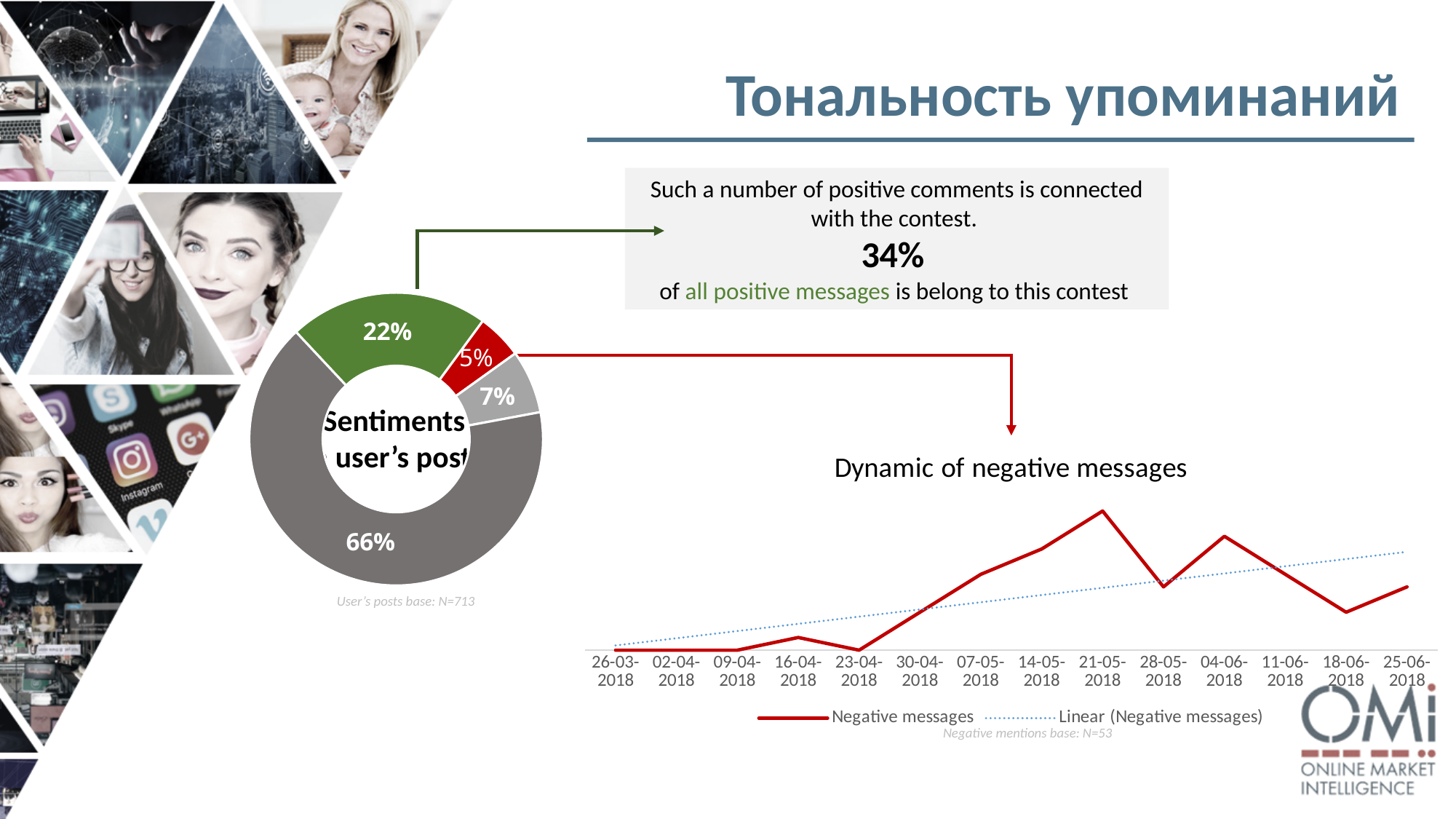
In the "Sentiments of user's posts" chart, what is the difference between the dark gray slice (66%) and the green slice (22%)? 44 percentage points In the "Dynamic of negative messages" chart, which date has more negative messages: 04-06-2018 or 18-06-2018? 04-06-2018 In the "Sentiments of user's posts" chart, what is the value of the largest slice? 66% What type of chart is the "Sentiments of user's posts" chart? Donut (pie) chart In the "Sentiments of user's posts" chart, how many slices are there? 4 In the "Dynamic of negative messages" chart, how many dates are shown on the x axis? 14 In the "Sentiments of user's posts" chart, what is the value of the red slice? 5% In the "Dynamic of negative messages" chart, how many series does the legend list? 2 In the "Sentiments of user's posts" chart, what is the value of the green slice? 22% In the "Sentiments of user's posts" chart, what is the value of the smallest slice? 5% In the "Dynamic of negative messages" chart, on which date do negative messages reach their peak? 21-05-2018 What type of chart is "Dynamic of negative messages"? Line chart